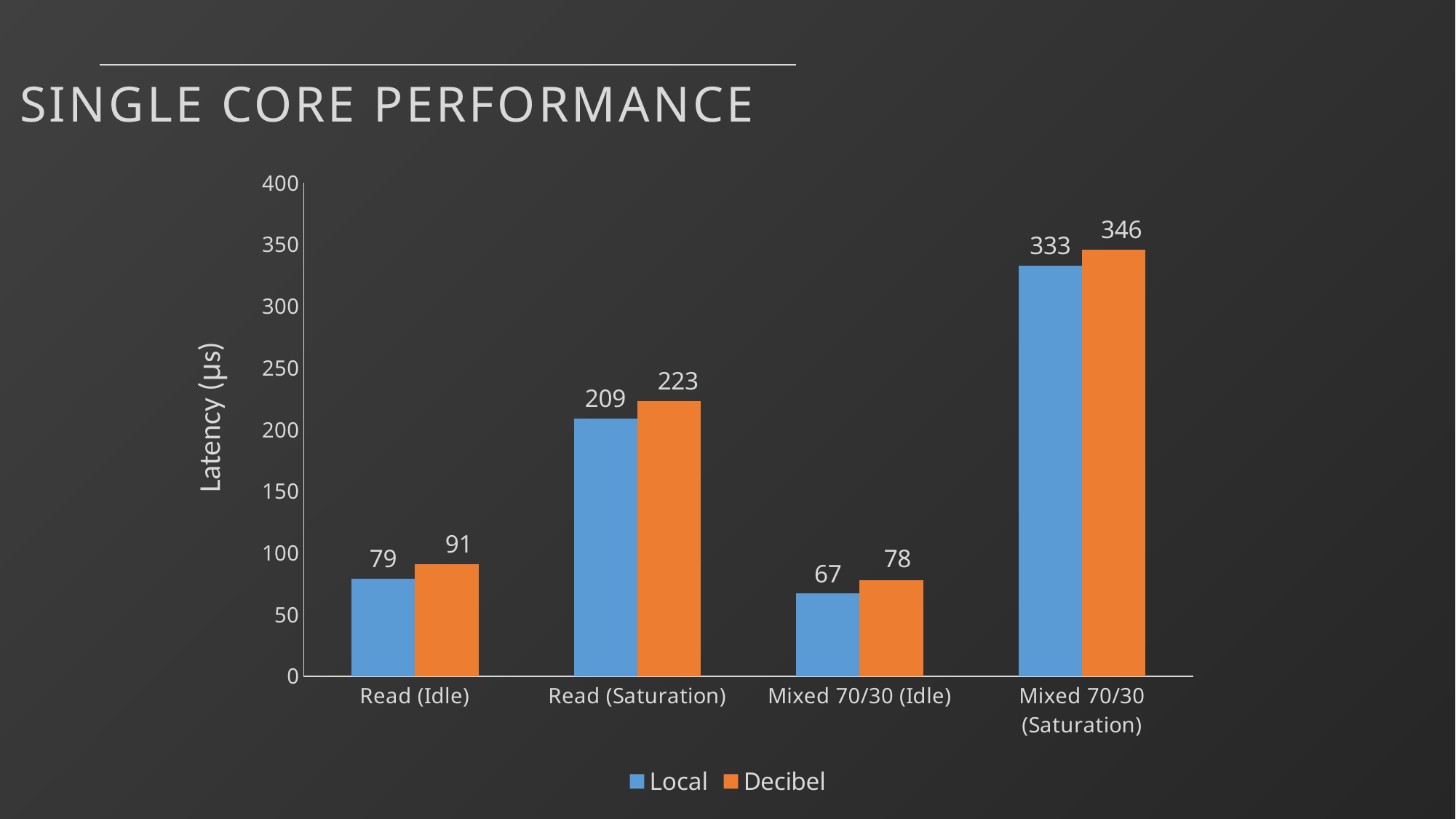
Which category has the lowest Local latency? Mixed 70/30 (Idle) What is the Decibel latency for Mixed 70/30 (Idle)? 78 Which is larger for Read (Idle): the Local latency or the Decibel latency? Decibel What is the difference between the Decibel and Local latency for Read (Saturation)? 14 How many series does the legend list? 2 What is the difference between the Decibel and Local latency for Mixed 70/30 (Saturation)? 13 What is the Decibel latency for Read (Idle)? 91 What kind of chart is shown on the slide? Bar chart What is the Local latency for Read (Saturation)? 209 Which category has the highest Decibel latency? Mixed 70/30 (Saturation) How many categories are shown on the x axis? 4 What is the label of the y axis? Latency (µs)